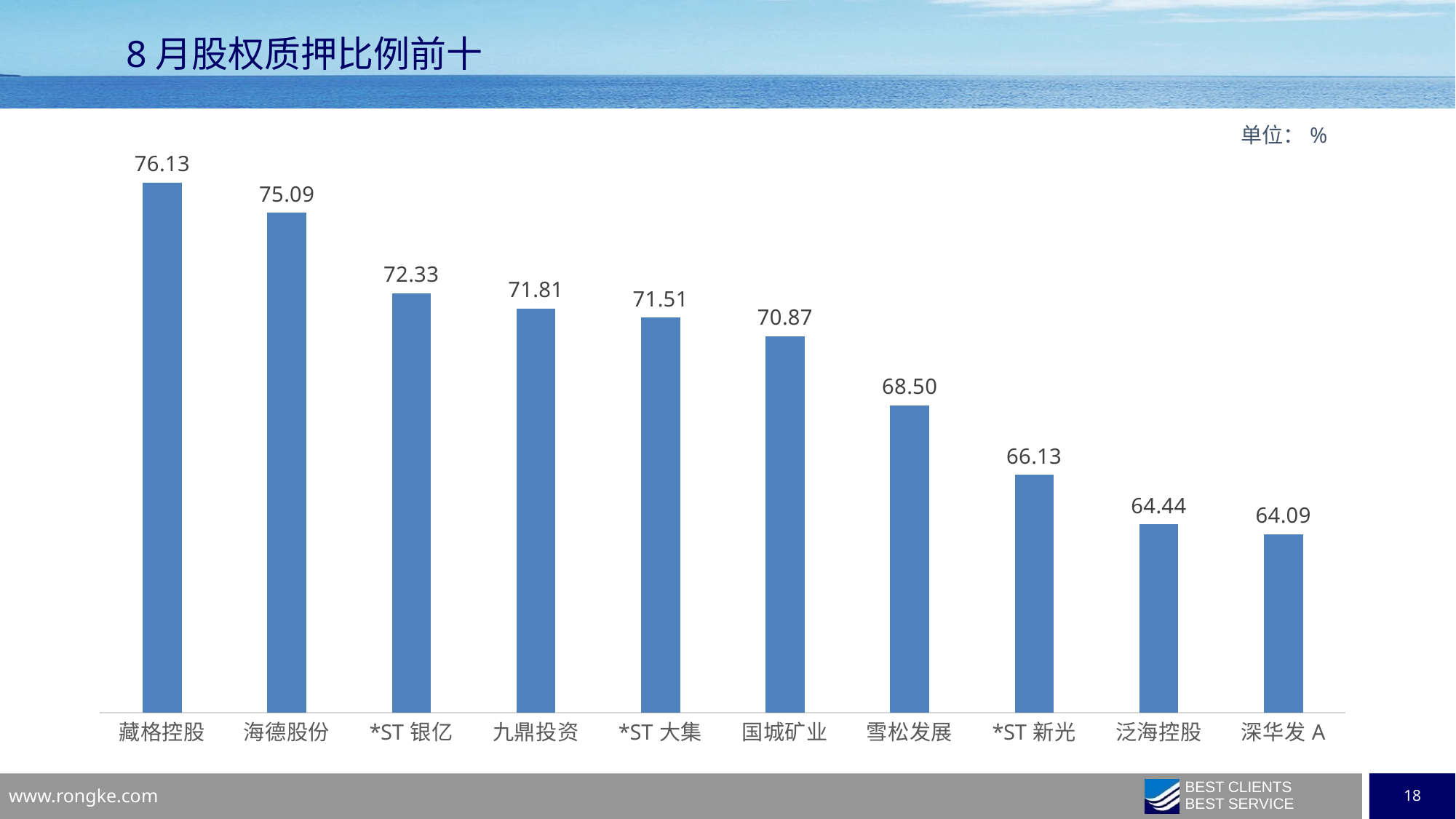
What is the difference between the values for *ST 新光 and 泛海控股? 1.69 What type of chart is shown on the slide? Bar chart What is the value for 雪松发展? 68.50 How many categories are shown in the chart? 10 What unit is indicated for the values in the chart? % What is the value for 国城矿业? 70.87 What is the value for 藏格控股? 76.13 What is the difference between the values for 藏格控股 and 海德股份? 1.04 Which category has the lowest value? 深华发 A What is the value for 深华发 A? 64.09 Which is larger, the value for *ST 银亿 or the value for 雪松发展? *ST 银亿 Which category has the highest value? 藏格控股